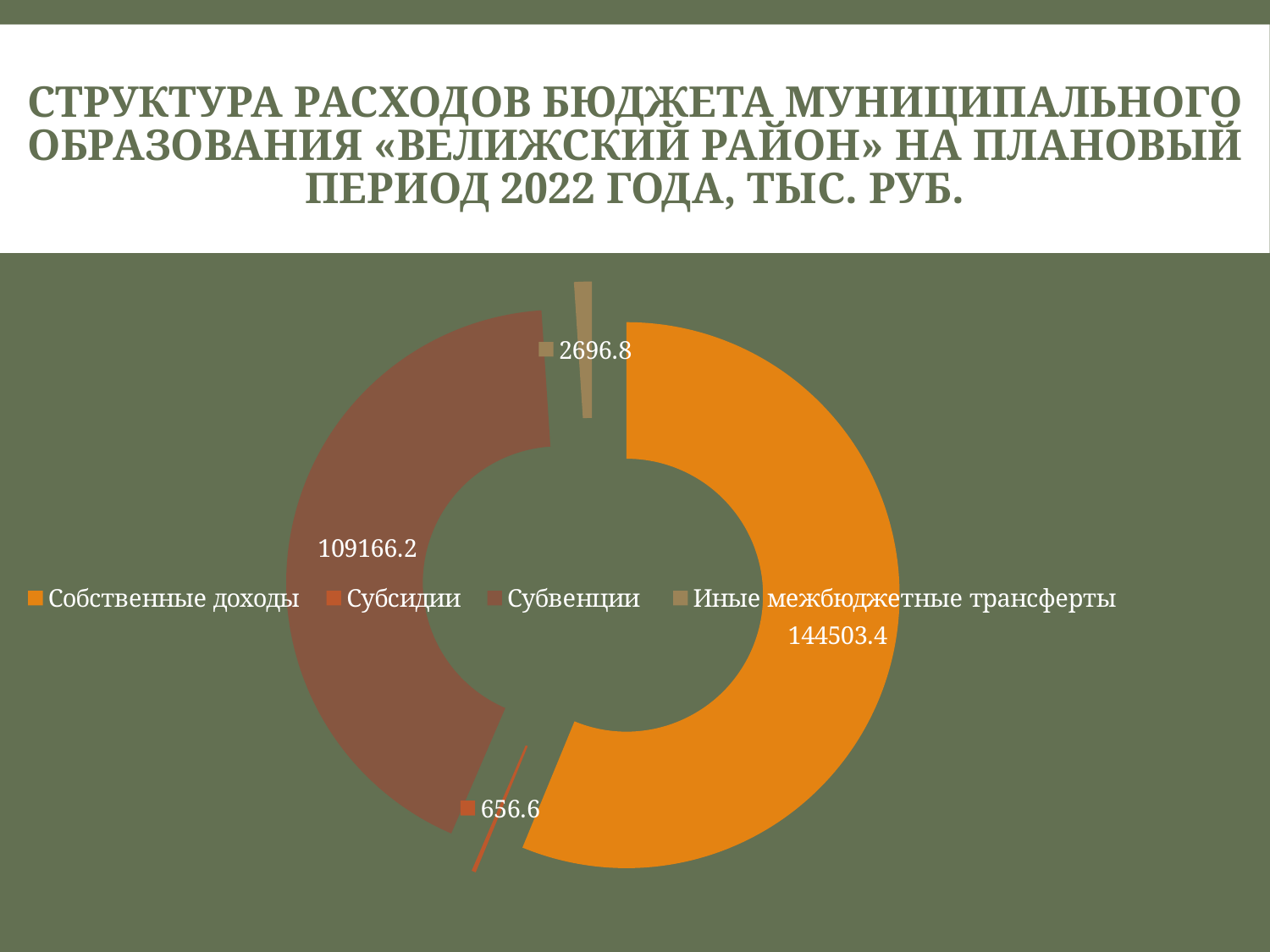
What is the difference between Собственные доходы and Субвенции? 35337.2 What is the value for Субсидии? 656.6 What is the value for Иные межбюджетные трансферты? 2696.8 Which category has the highest value? Собственные доходы What is the value for Собственные доходы? 144503.4 What kind of chart is shown on the slide? Doughnut chart Which category has the lowest value? Субсидии What is the total of all four categories shown in the chart? 257023.0 How many categories does the chart show? 4 What is the value for Субвенции? 109166.2 Which is larger, Субвенции or Иные межбюджетные трансферты? Субвенции What is the difference between Иные межбюджетные трансферты and Субсидии? 2040.2